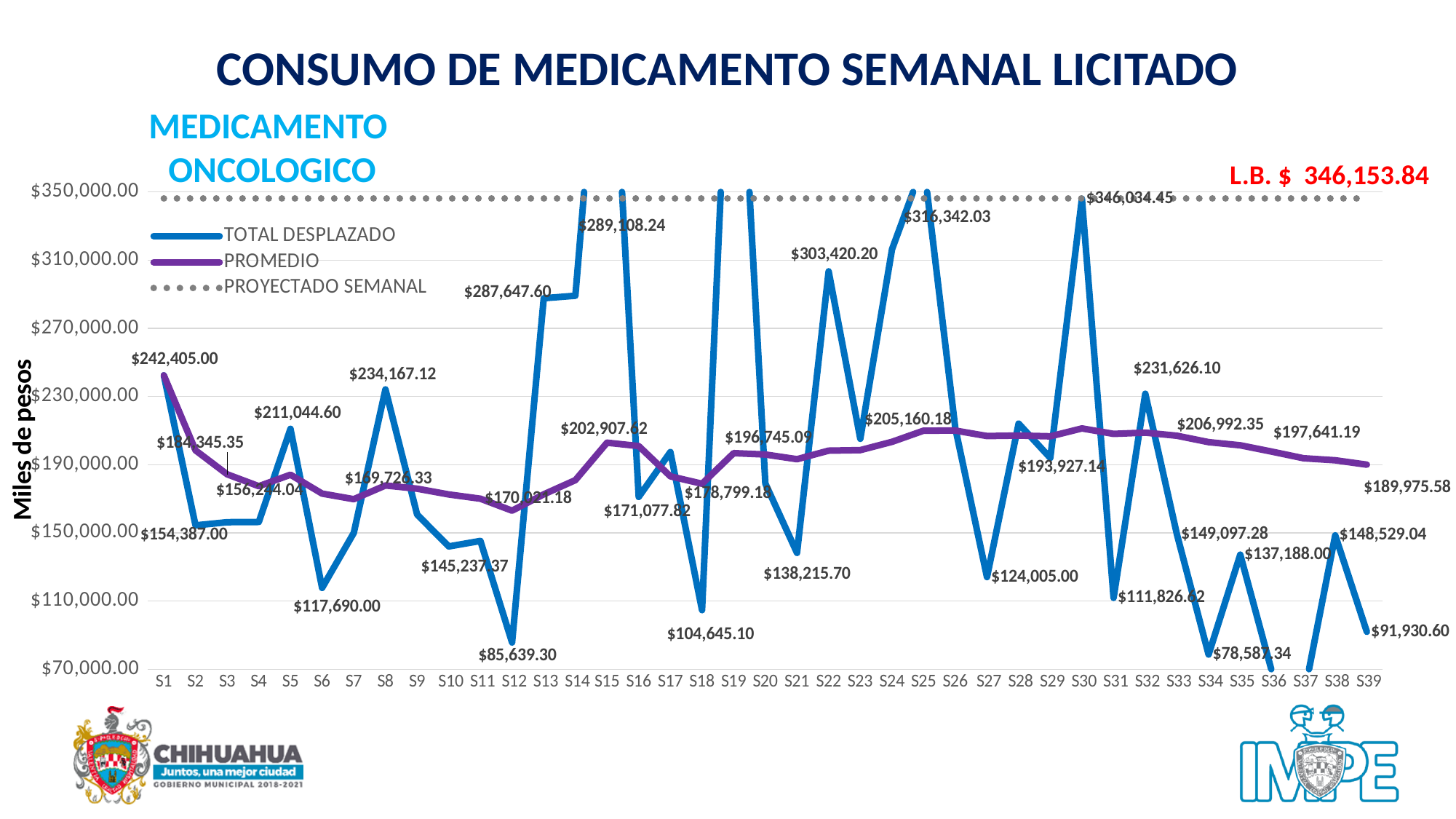
What is the value of TOTAL DESPLAZADO at S1? $242,405.00 What is the value of TOTAL DESPLAZADO at S30? $346,034.45 What L.B. value is printed in red at the top right of the chart? $ 346,153.84 Is the TOTAL DESPLAZADO value at S22 greater or less than $270,000.00? greater What is the value of TOTAL DESPLAZADO at S39? $91,930.60 What is the difference between the TOTAL DESPLAZADO values at S8 ($234,167.12) and S6 ($117,690.00)? $116,477.12 How many series does the legend list? 3 What is the value of TOTAL DESPLAZADO at S12? $85,639.30 What kind of chart is shown on the slide? line chart Which is larger for TOTAL DESPLAZADO, the value at S8 or at S6? S8 What are the three entries in the chart legend? TOTAL DESPLAZADO, PROMEDIO, PROYECTADO SEMANAL How many weeks (S1 to S39) are plotted along the x axis? 39